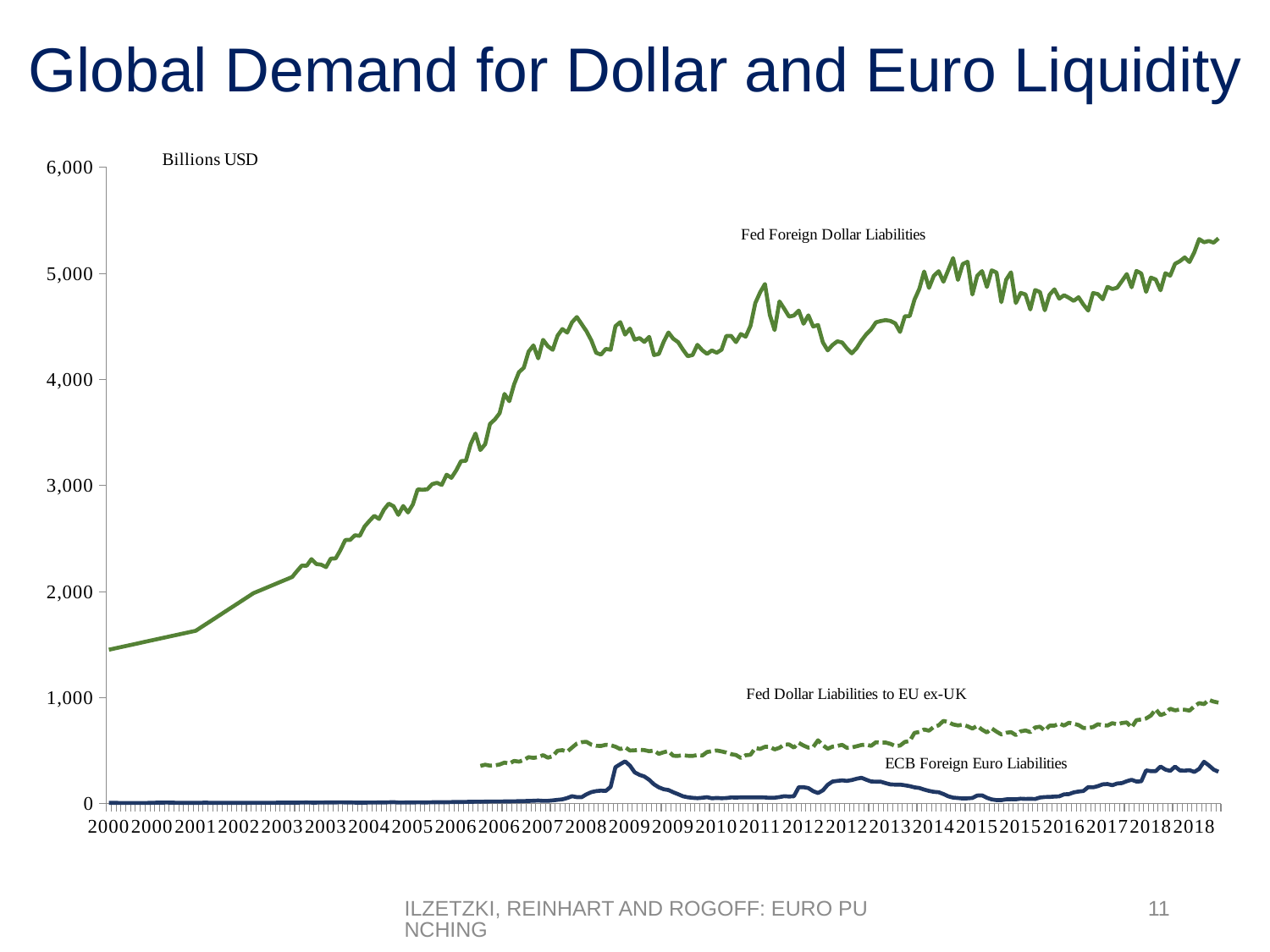
Which series has the lowest values on the chart? ECB Foreign Euro Liabilities Do Fed Foreign Dollar Liabilities generally rise or fall from 2000 to 2018? rise What is the title of the chart on the slide? Global Demand for Dollar and Euro Liquidity What unit is shown for the vertical axis of the chart? Billions USD Is the value of Fed Foreign Dollar Liabilities at the start of 2000 greater or less than 1,000? greater Which series reaches the highest values on the chart? Fed Foreign Dollar Liabilities Is the value of Fed Dollar Liabilities to EU ex-UK at the end of 2018 greater or less than 2,000? less Is the value of ECB Foreign Euro Liabilities at the end of 2018 greater or less than 1,000? less Which is larger in 2018, Fed Foreign Dollar Liabilities or ECB Foreign Euro Liabilities? Fed Foreign Dollar Liabilities How many series are plotted on the chart? 3 What kind of chart is shown on the slide? line chart